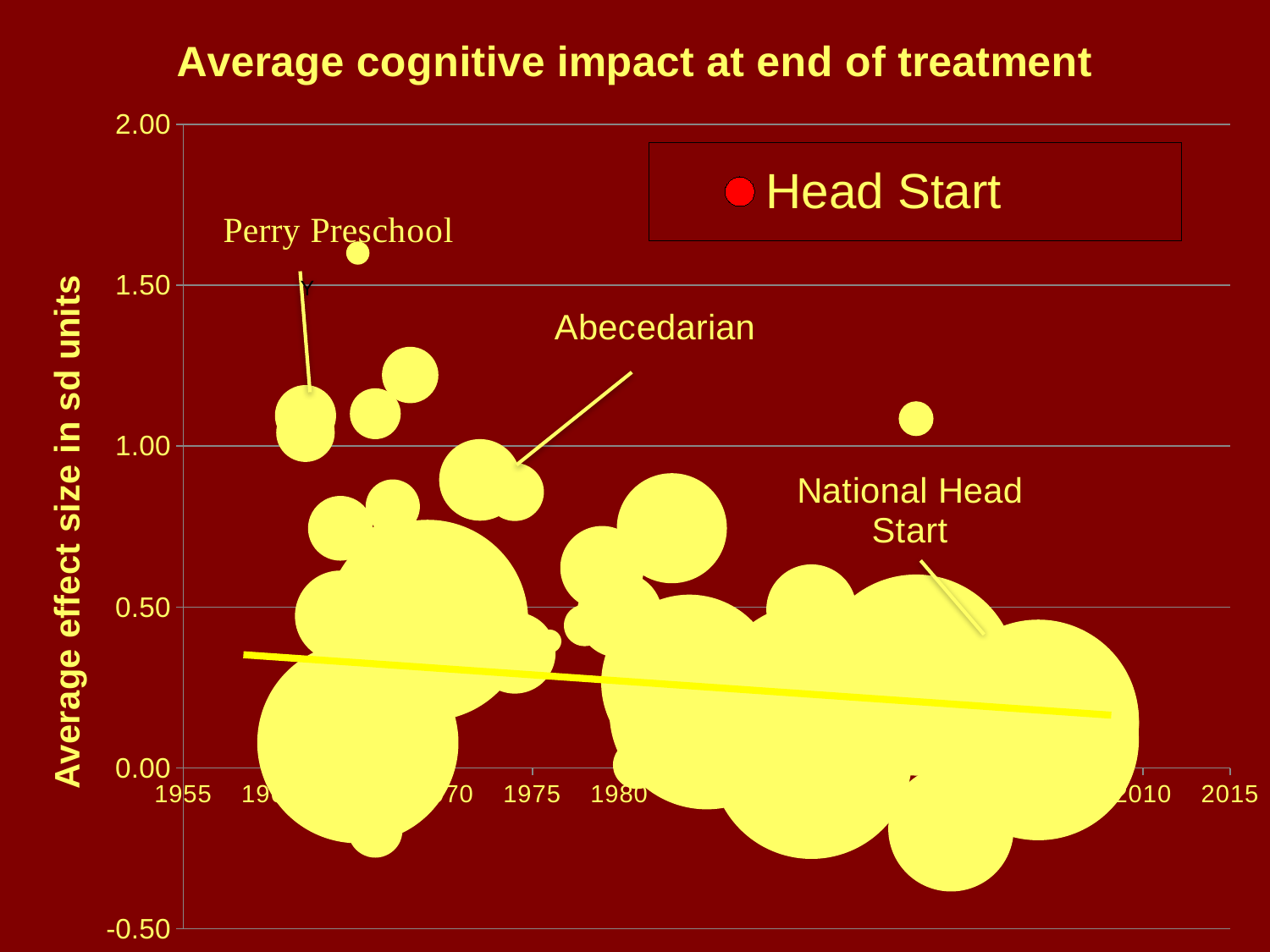
What kind of chart is shown on the slide? Bubble chart Is the effect size for National Head Start greater or less than 1.00? less Of the three labeled programs (Perry Preschool, Abecedarian, National Head Start), which has the highest effect size? Perry Preschool What is the label on the vertical axis of the chart? Average effect size in sd units Does the trend line in the chart rise or fall as the year increases? Fall How many series does the legend list? 1 Which has the larger effect size, Perry Preschool or Abecedarian? Perry Preschool What is the title of the chart? Average cognitive impact at end of treatment Which has the larger effect size, Abecedarian or National Head Start? Abecedarian Is the effect size for Abecedarian greater or less than 1.00? less Of the three labeled programs (Perry Preschool, Abecedarian, National Head Start), which has the lowest effect size? National Head Start Is the effect size for Perry Preschool greater or less than 0.50? greater